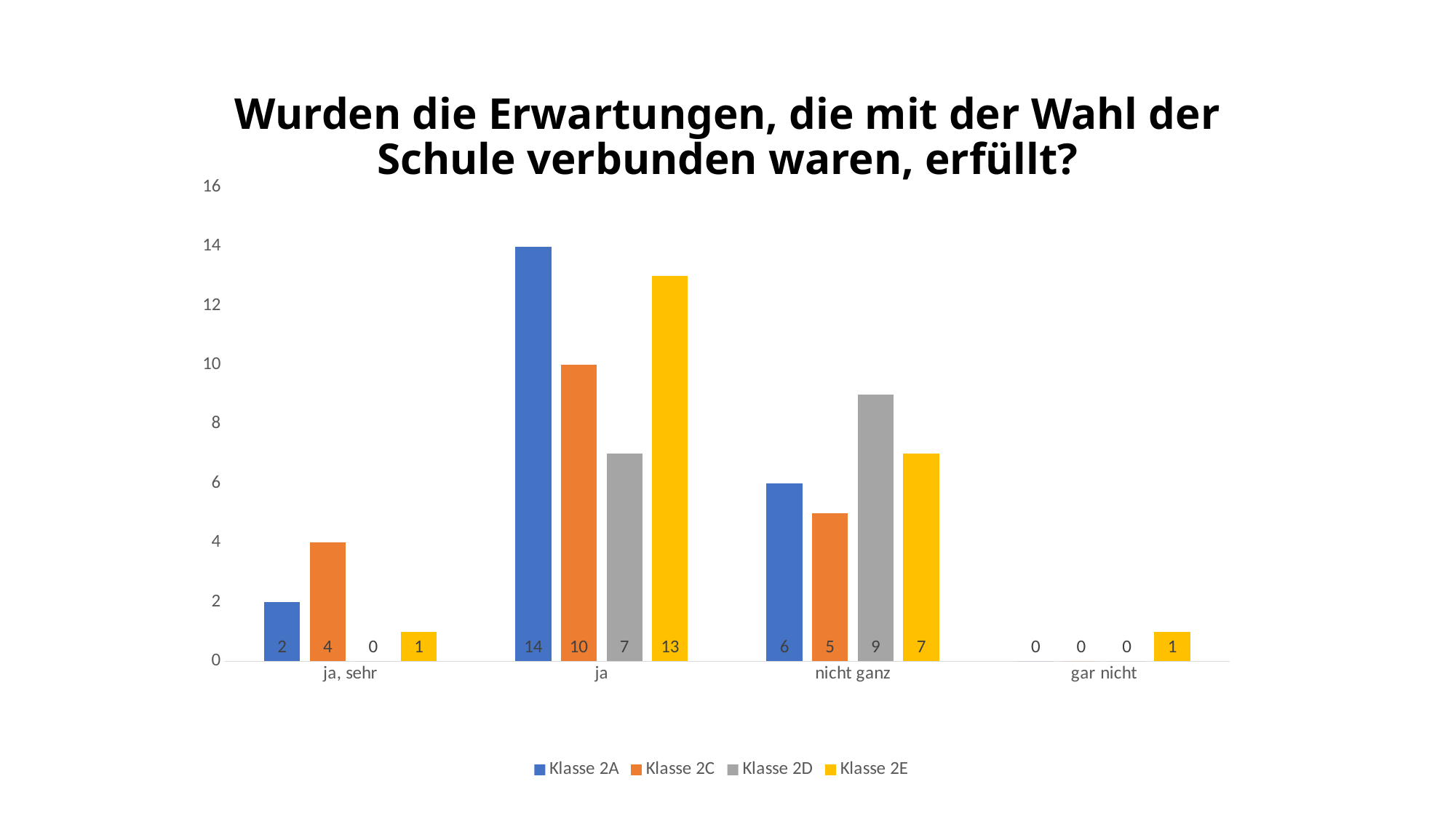
What is the value for Klasse 2A in the "ja" category? 14 What kind of chart is shown on the slide? Bar chart What is the value for Klasse 2E in the "gar nicht" category? 1 What is the difference between Klasse 2A and Klasse 2C in the "ja" category? 4 How many categories are shown on the x axis? 4 Which is larger in the "nicht ganz" category: Klasse 2D or Klasse 2E? Klasse 2D Which class has the lowest value in the "ja" category? Klasse 2D Which colour represents Klasse 2E in the legend? Yellow What is the value for Klasse 2D in the "nicht ganz" category? 9 What is the total of all four classes in the "nicht ganz" category? 27 Which class has the highest value in the "ja, sehr" category? Klasse 2C How many series does the legend list? 4